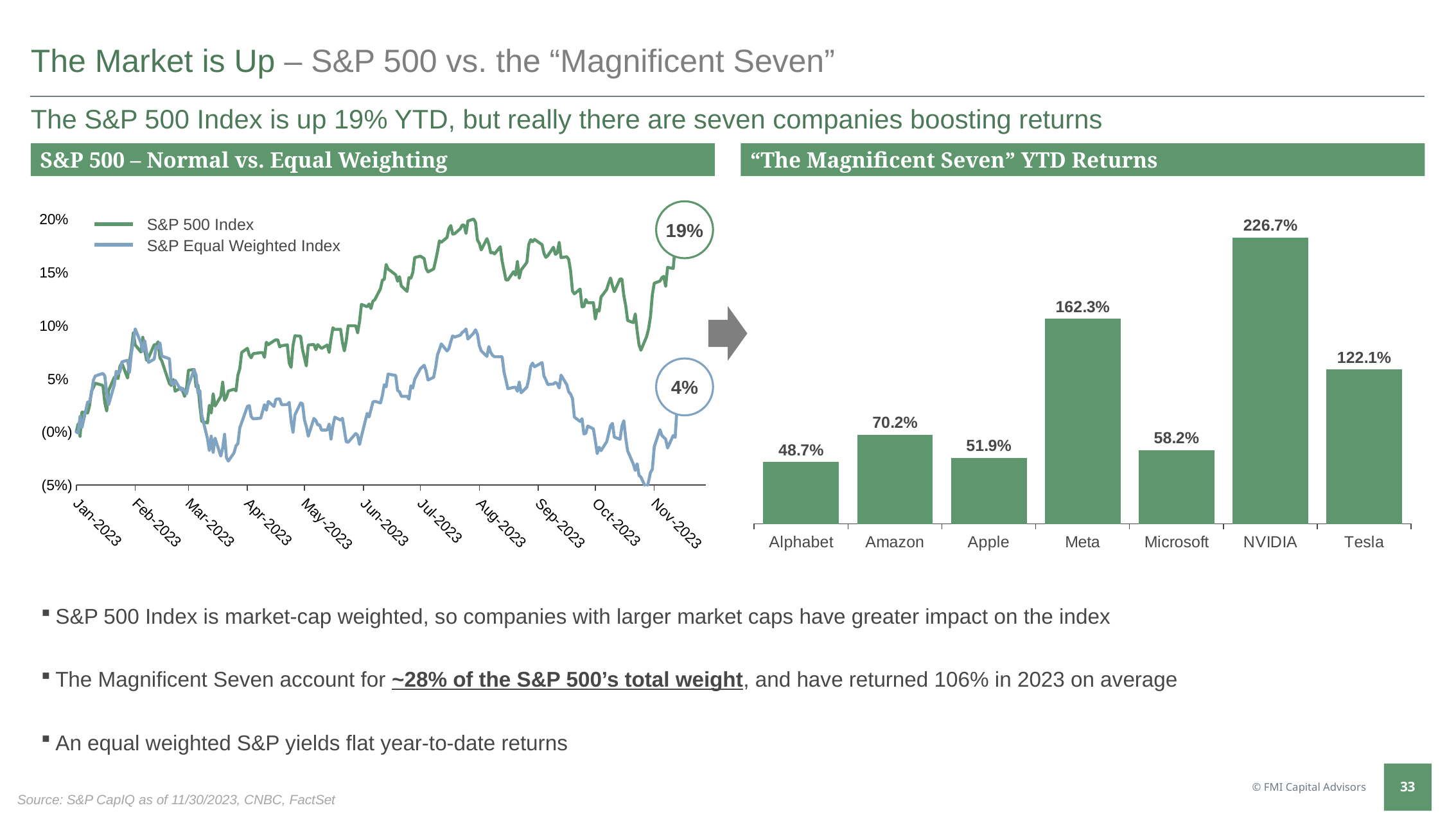
In the "The Magnificent Seven" YTD Returns chart, what is the YTD return for NVIDIA? 226.7% What type of chart is the "The Magnificent Seven" YTD Returns chart? Bar chart In the "The Magnificent Seven" YTD Returns chart, which has a higher YTD return, Amazon or Microsoft? Amazon In the "The Magnificent Seven" YTD Returns chart, what is the difference between Meta's and Tesla's YTD returns? 40.2% What type of chart is the S&P 500 – Normal vs. Equal Weighting chart? Line chart In the "The Magnificent Seven" YTD Returns chart, what is the YTD return for Alphabet? 48.7% In the "The Magnificent Seven" YTD Returns chart, which company has the highest YTD return? NVIDIA In the S&P 500 – Normal vs. Equal Weighting chart, what is the labeled ending value for the S&P 500 Index? 19% How many series does the legend of the S&P 500 – Normal vs. Equal Weighting chart list? 2 In the S&P 500 – Normal vs. Equal Weighting chart, what is the labeled ending value for the S&P Equal Weighted Index? 4% How many companies are shown in the "The Magnificent Seven" YTD Returns chart? 7 In the "The Magnificent Seven" YTD Returns chart, which company has the lowest YTD return? Alphabet